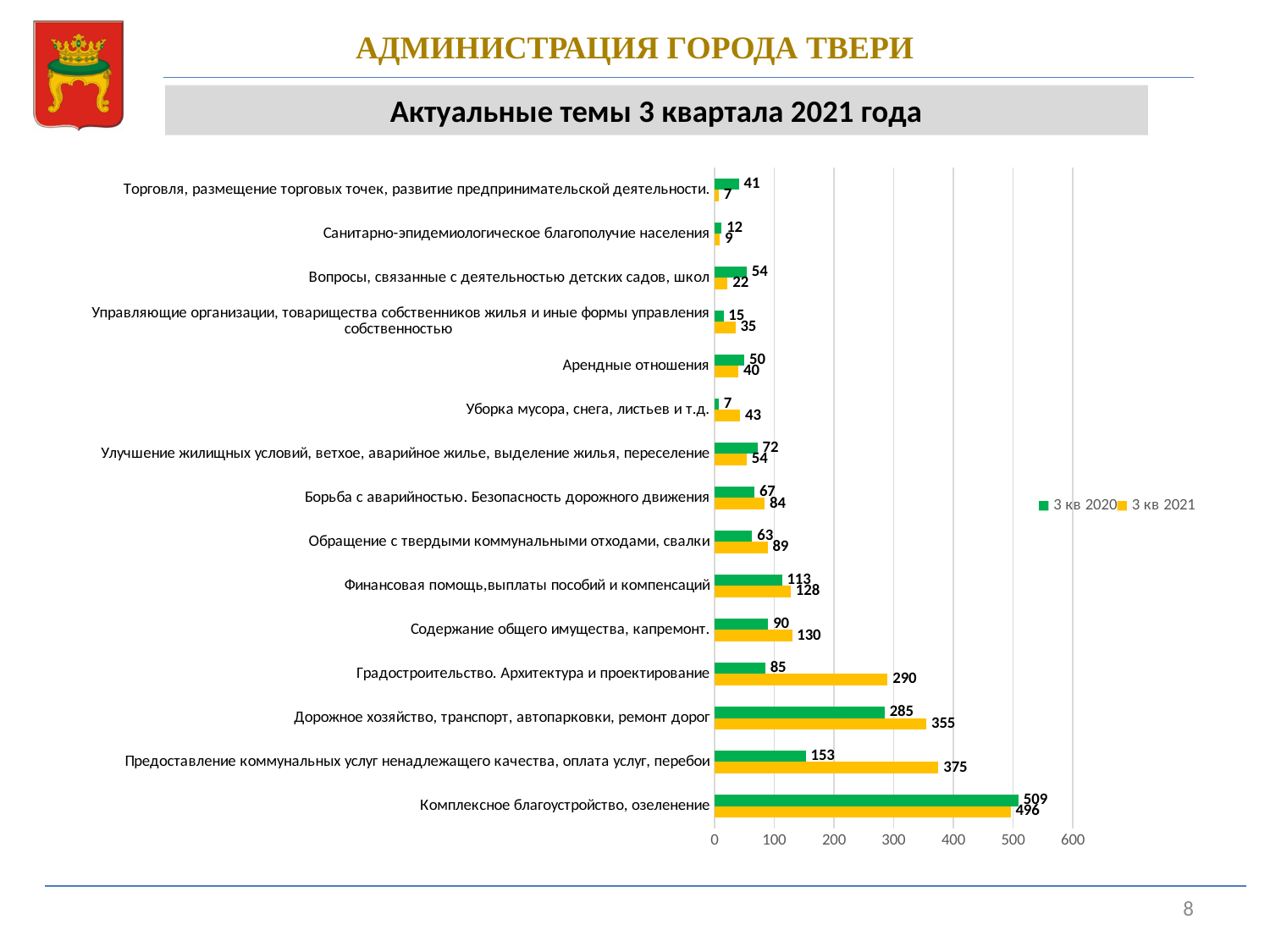
What type of chart is shown on the slide? bar chart How many series does the legend list? 2 Which category has the lowest value in the "3 кв 2020" series? Уборка мусора, снега, листьев и т.д. Is the "3 кв 2021" value for "Градостроительство. Архитектура и проектирование" greater or less than 200? greater Which category has the lowest value in the "3 кв 2021" series? Торговля, размещение торговых точек, развитие предпринимательской деятельности. What is the value for "Градостроительство. Архитектура и проектирование" in the "3 кв 2020" series? 85 What is the value for "Дорожное хозяйство, транспорт, автопарковки, ремонт дорог" in the "3 кв 2021" series? 355 How many categories are shown in the chart? 15 What colour are the bars for the "3 кв 2021" series? yellow Which category has the highest value in the "3 кв 2021" series? Комплексное благоустройство, озеленение For "Комплексное благоустройство, озеленение", which series has the larger value: "3 кв 2020" or "3 кв 2021"? 3 кв 2020 What is the difference between the "3 кв 2021" and "3 кв 2020" values for "Предоставление коммунальных услуг ненадлежащего качества, оплата услуг, перебои"? 222